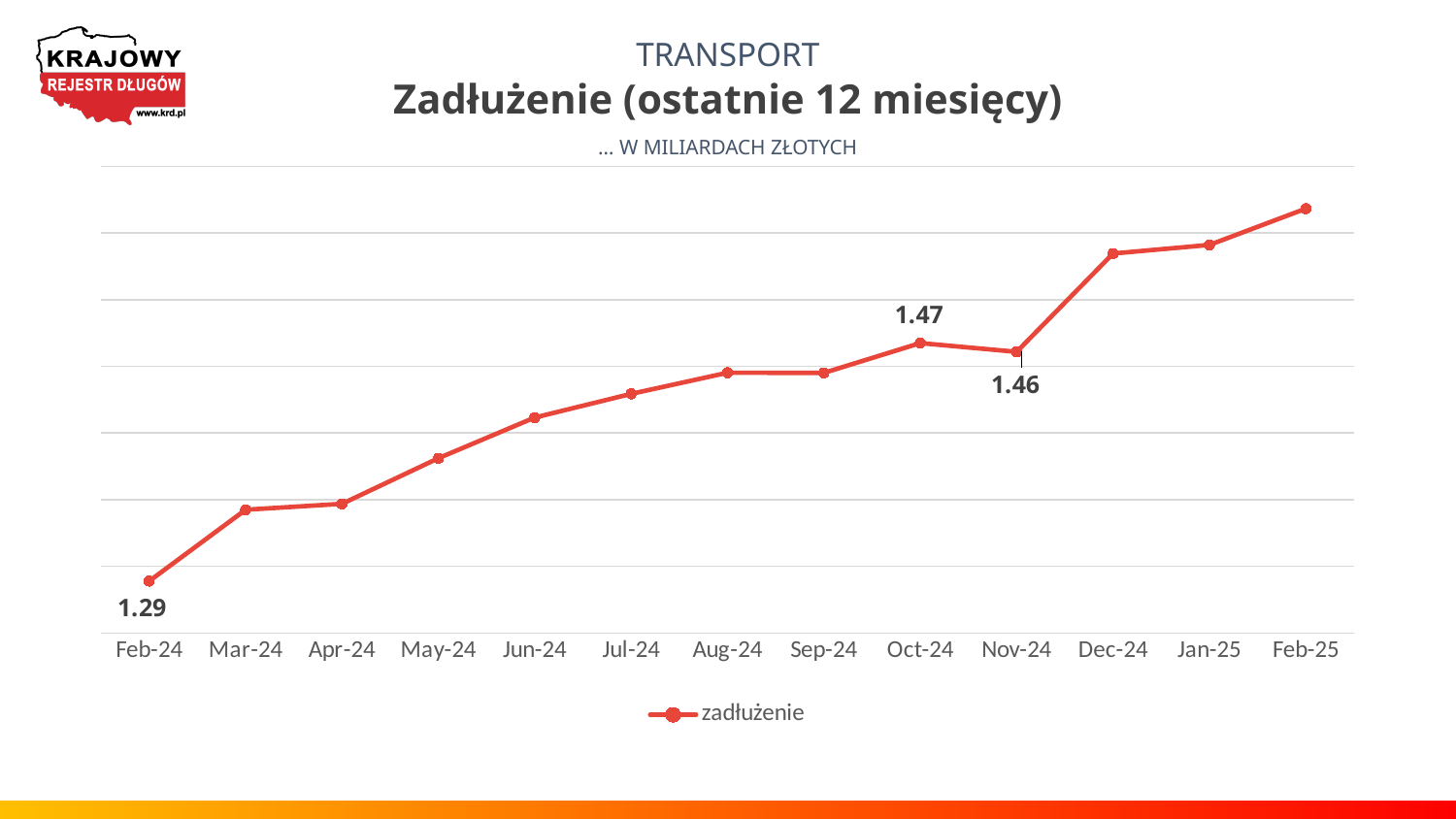
What is the name of the series shown in the legend? zadłużenie What kind of chart is shown on the slide? Line chart What is the value for Oct-24? 1.47 Do the values generally rise or fall from Feb-24 to Feb-25? Rise Which month has the lowest value? Feb-24 What is the value for Nov-24? 1.46 What is the difference between the values for Oct-24 and Nov-24? 0.01 How many series does the legend list? 1 What is the value for Feb-24? 1.29 How many data points are plotted on the chart? 13 Which month has the highest value? Feb-25 Which is larger, the value for Oct-24 or the value for Nov-24? Oct-24